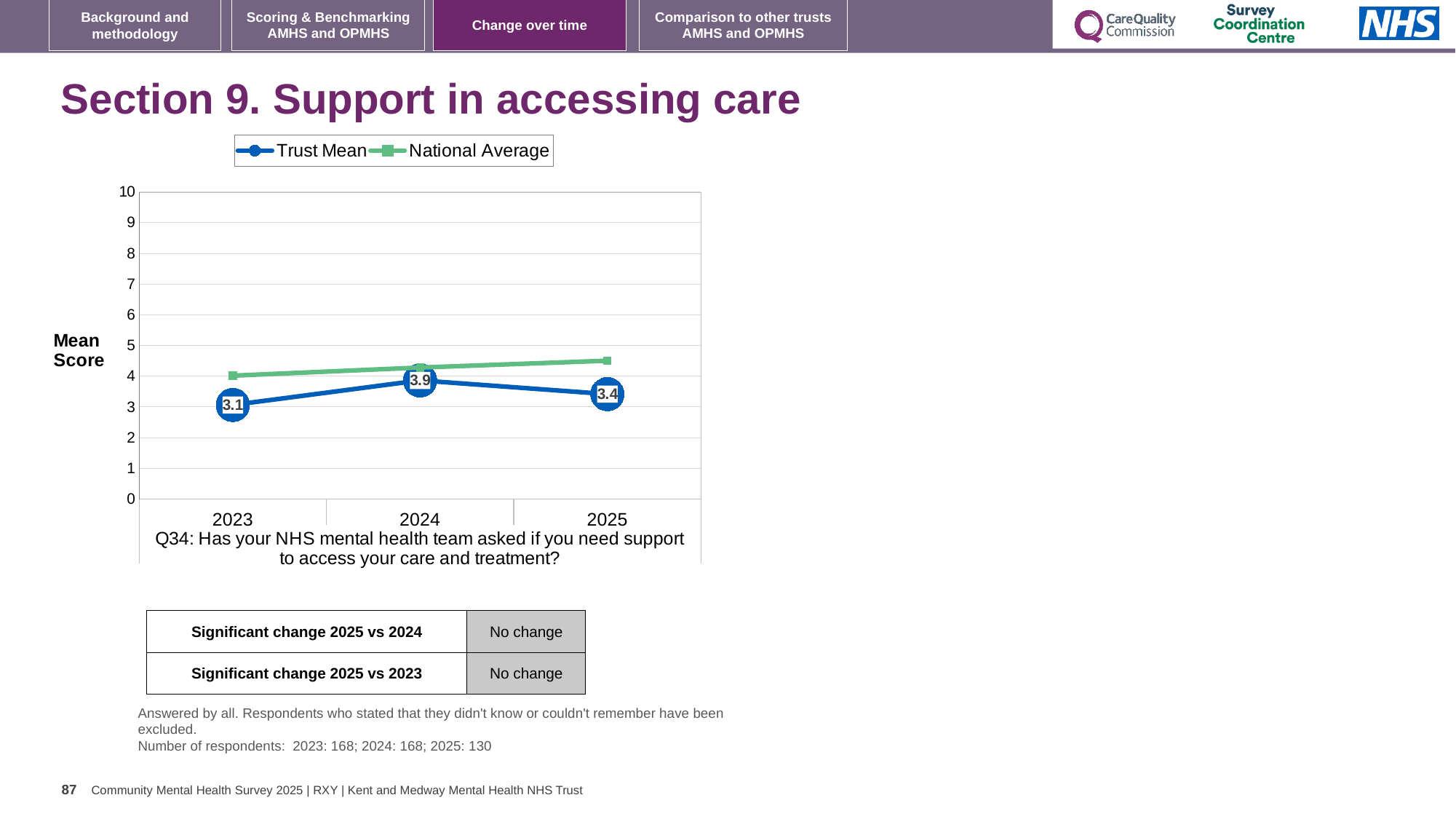
What kind of chart is shown on the slide? line chart What is the Trust Mean score for 2023? 3.1 What is the difference between the Trust Mean in 2024 and in 2023? 0.8 In 2025, which is larger: the Trust Mean or the National Average? National Average What is the Trust Mean score for 2025? 3.4 What is the Trust Mean score for 2024? 3.9 Is the National Average for 2025 greater or less than 4? greater In which year is the Trust Mean highest? 2024 What is the difference between the Trust Mean in 2024 and in 2025? 0.5 How many series does the legend list? 2 Does the National Average rise or fall from 2023 to 2025? rise In which year is the Trust Mean lowest? 2023